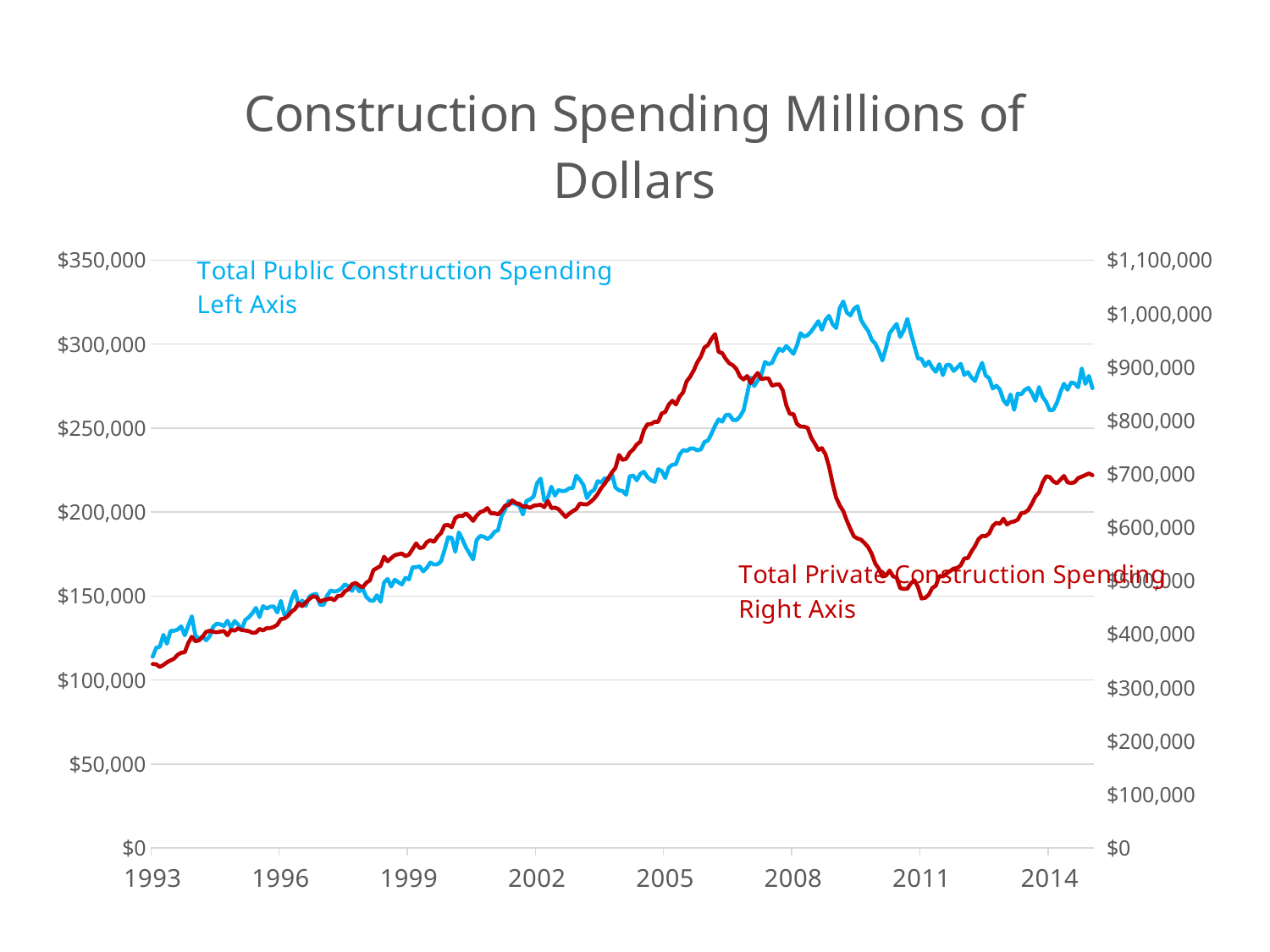
Is the value for Total Private Construction Spending in 1993 greater or less than $400,000? less Is the value for Total Private Construction Spending at its low point around 2011 greater or less than $500,000? less What is the title of the chart? Construction Spending Millions of Dollars Does Total Public Construction Spending rise or fall between 1993 and 2009? rise How many data series are plotted on the chart? 2 What kind of chart is shown on the slide? line chart Is the peak value of Total Private Construction Spending around 2006 greater or less than $900,000? greater Does Total Private Construction Spending rise or fall between 2011 and 2014? rise Does Total Private Construction Spending rise or fall between 2006 and 2011? fall Which axis is used for Total Public Construction Spending? Left Axis